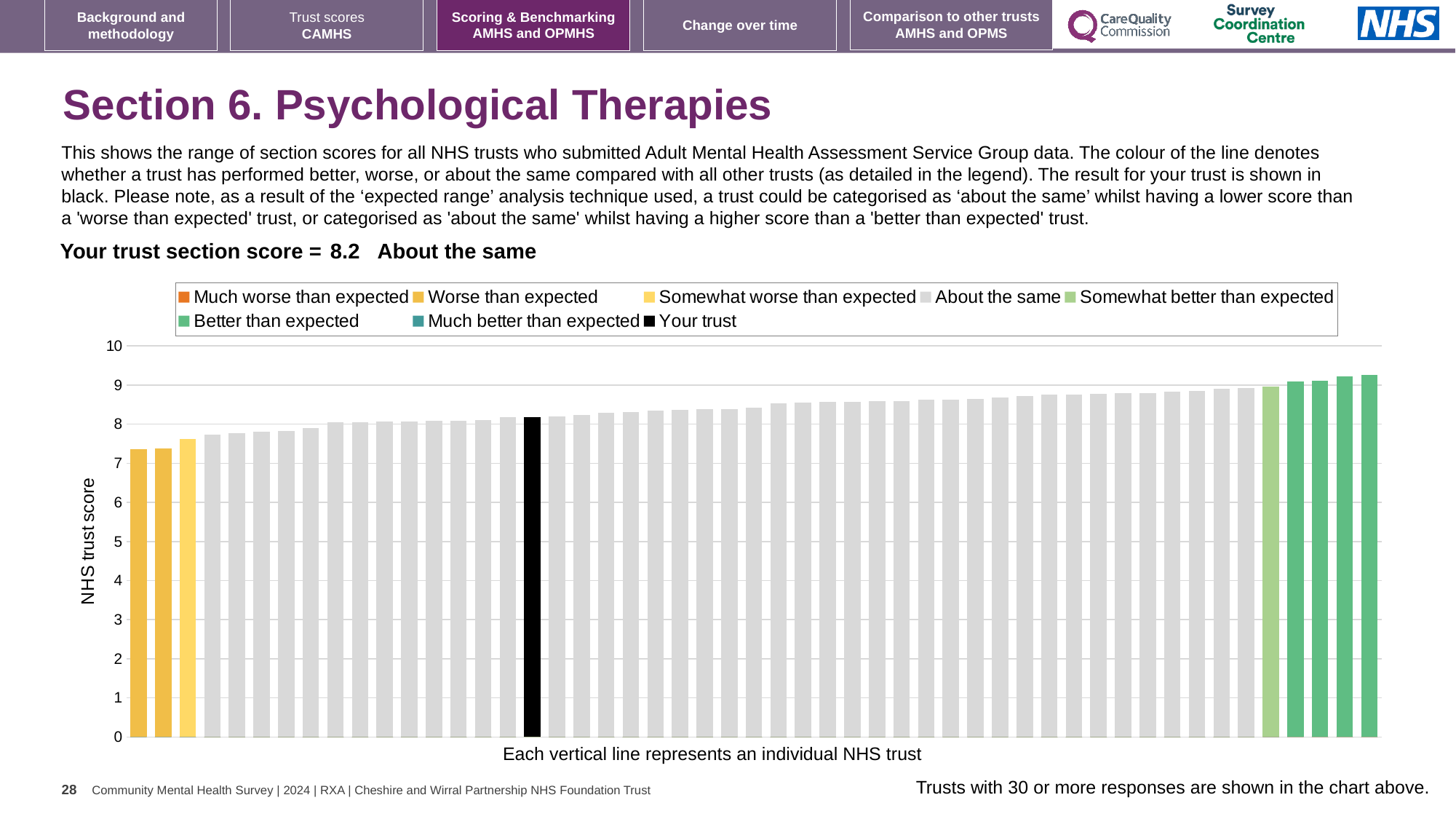
Is the value of the rightmost bar greater or less than 9? greater What is the section score for your trust shown on the slide? 8.2 Which is larger: the value of the rightmost bar or the value of your trust's bar? the rightmost bar How many entries does the chart legend list? 8 Is the value of the leftmost bar greater or less than 8? less What is the label on the vertical axis of the chart? NHS trust score Do the bar values rise or fall from left to right along the x axis? rise Is the value for your trust (the black bar) greater or less than 8? greater How many bars are coloured as 'Worse than expected'? 2 What colour is used for the 'Your trust' bar in the chart? black What kind of chart is shown on the slide? bar chart How many bars are coloured as 'Better than expected'? 4